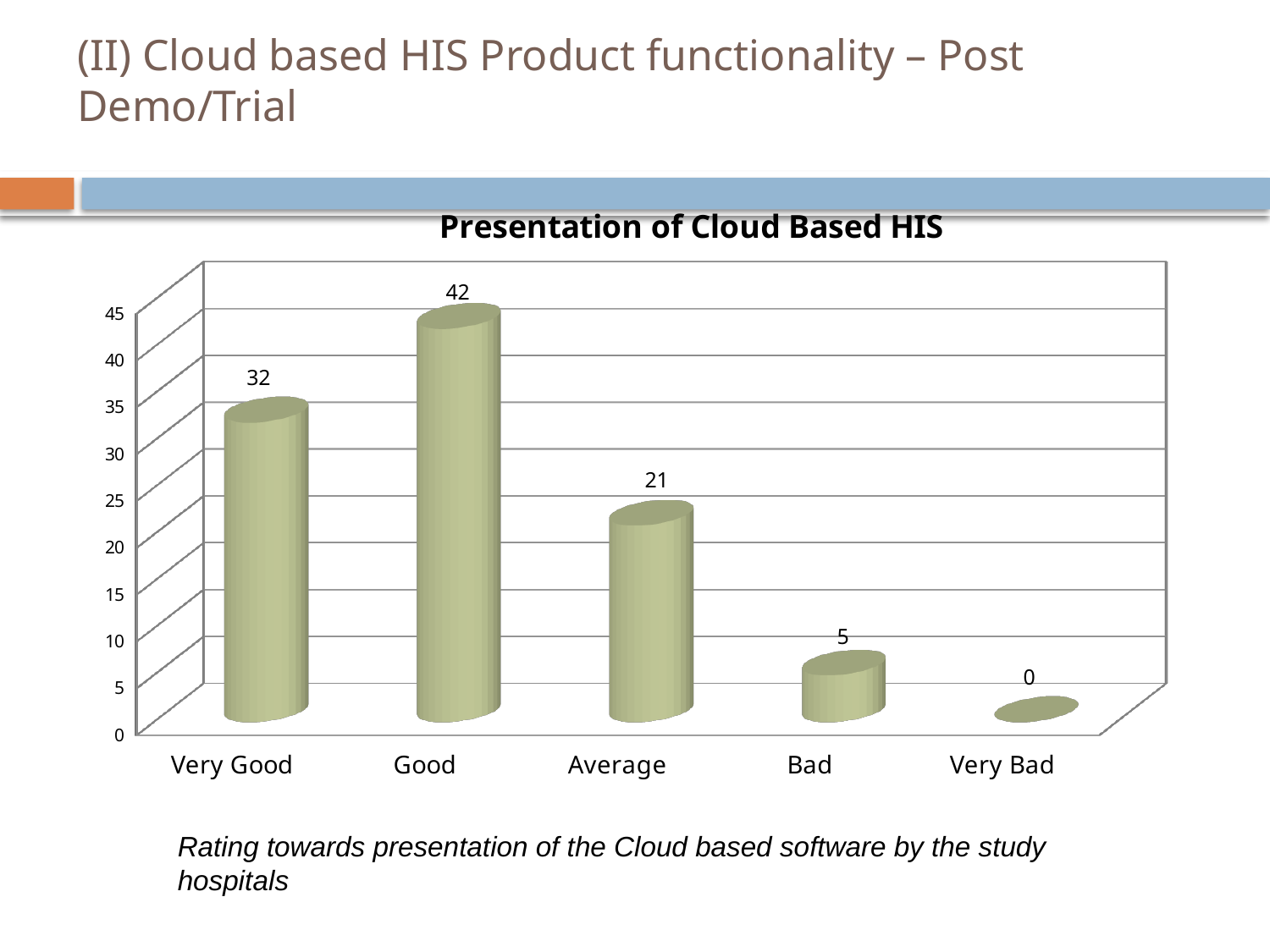
What is the title of the chart? Presentation of Cloud Based HIS Which category has the highest value? Good Which is larger, the value for Average or the value for Bad? Average How many categories are shown on the x axis? 5 What is the difference between the values for Good and Very Good? 10 What is the value for Good? 42 What is the value for Bad? 5 What is the value for Very Bad? 0 Which category has the lowest value? Very Bad What kind of chart is shown? Bar chart What is the value for Average? 21 What is the value for Very Good? 32